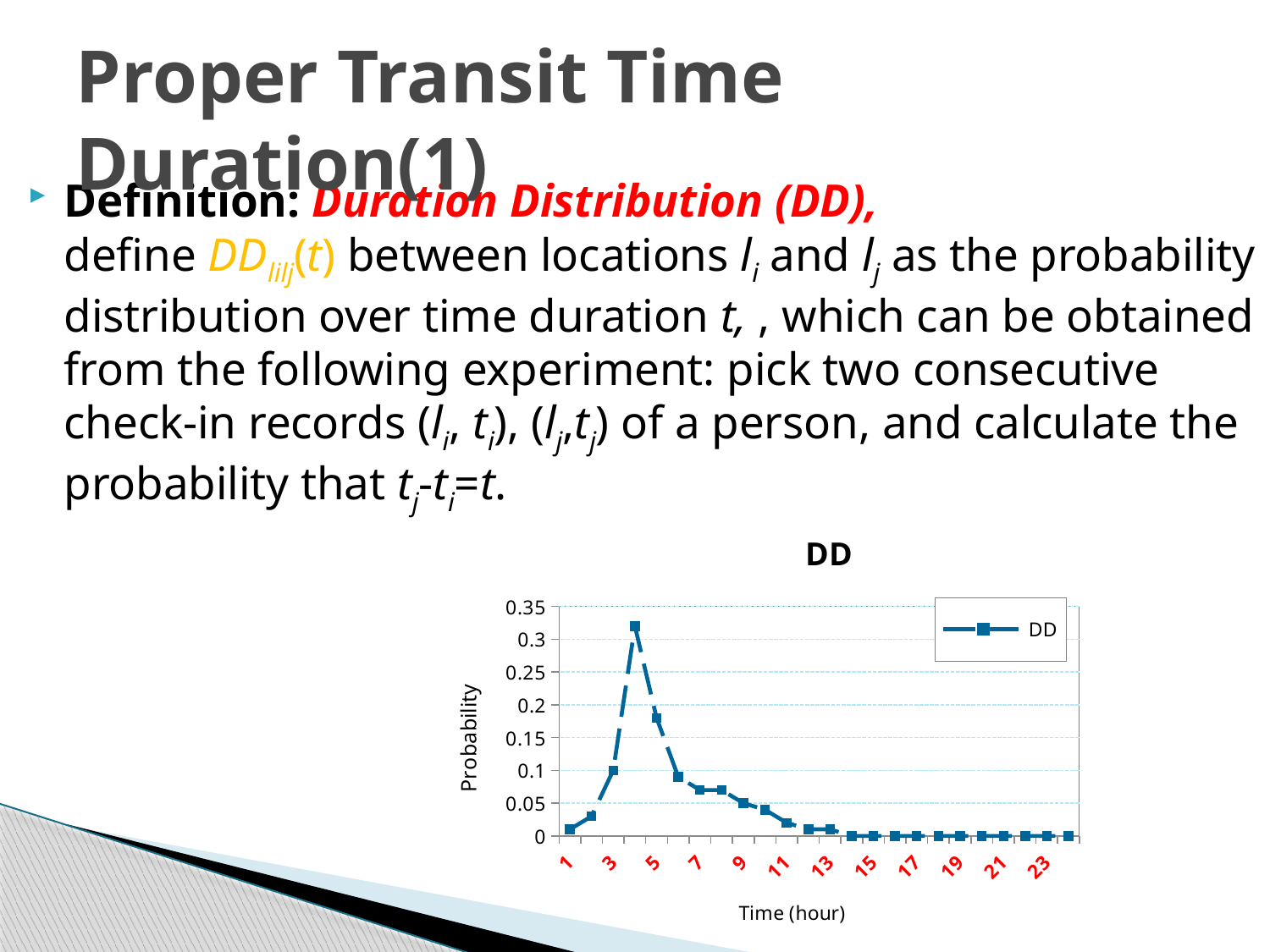
At which hour does the DD probability reach its highest value? 4 Is the probability at hour 4 greater or less than 0.3? greater Which has the higher probability, hour 3 or hour 5? hour 5 Is the probability at hour 5 greater or less than 0.15? greater Is the probability at hour 9 greater or less than 0.1? less What is the label of the x axis of the chart? Time (hour) How many series does the legend of the chart list? 1 What kind of chart is shown on the slide? line chart Which has the higher probability, hour 4 or hour 6? hour 4 After hour 4, does the probability rise or fall as time increases? fall What is the title of the chart? DD